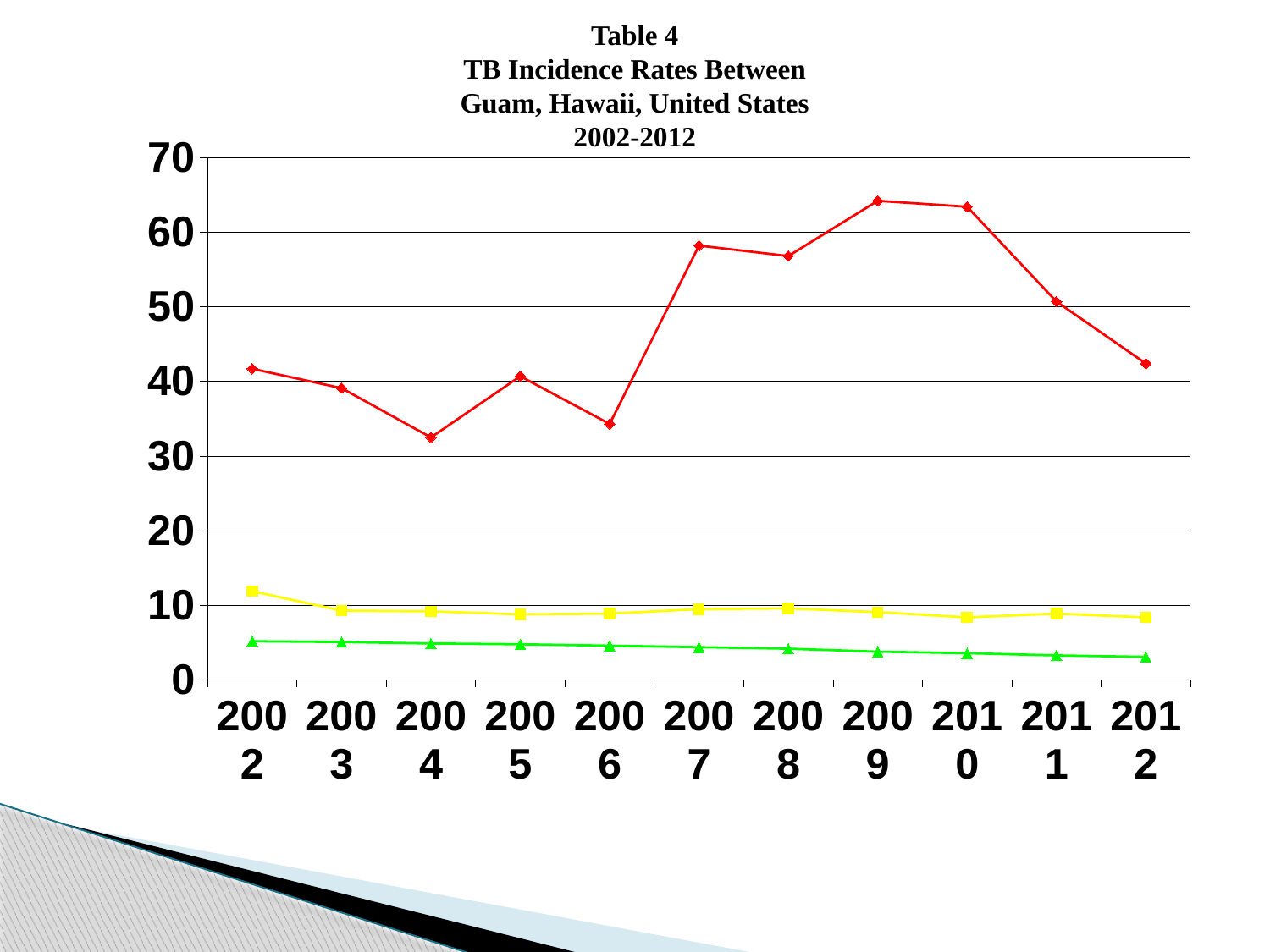
How many lines are plotted on the chart? 3 Is the value of the green line for 2012 greater or less than 5? less Is the value of the yellow line for 2002 greater or less than 10? greater Which three places does the chart title say the TB incidence rates are compared between? Guam, Hawaii, United States For the red line, is the value for 2007 larger or smaller than the value for 2006? larger Is the value of the red line for 2009 greater or less than 60? greater Which line has the highest values across all years: red, yellow or green? red How many years are plotted along the x axis? 11 What kind of chart is shown on the slide? line chart What is the highest value shown on the y axis? 70